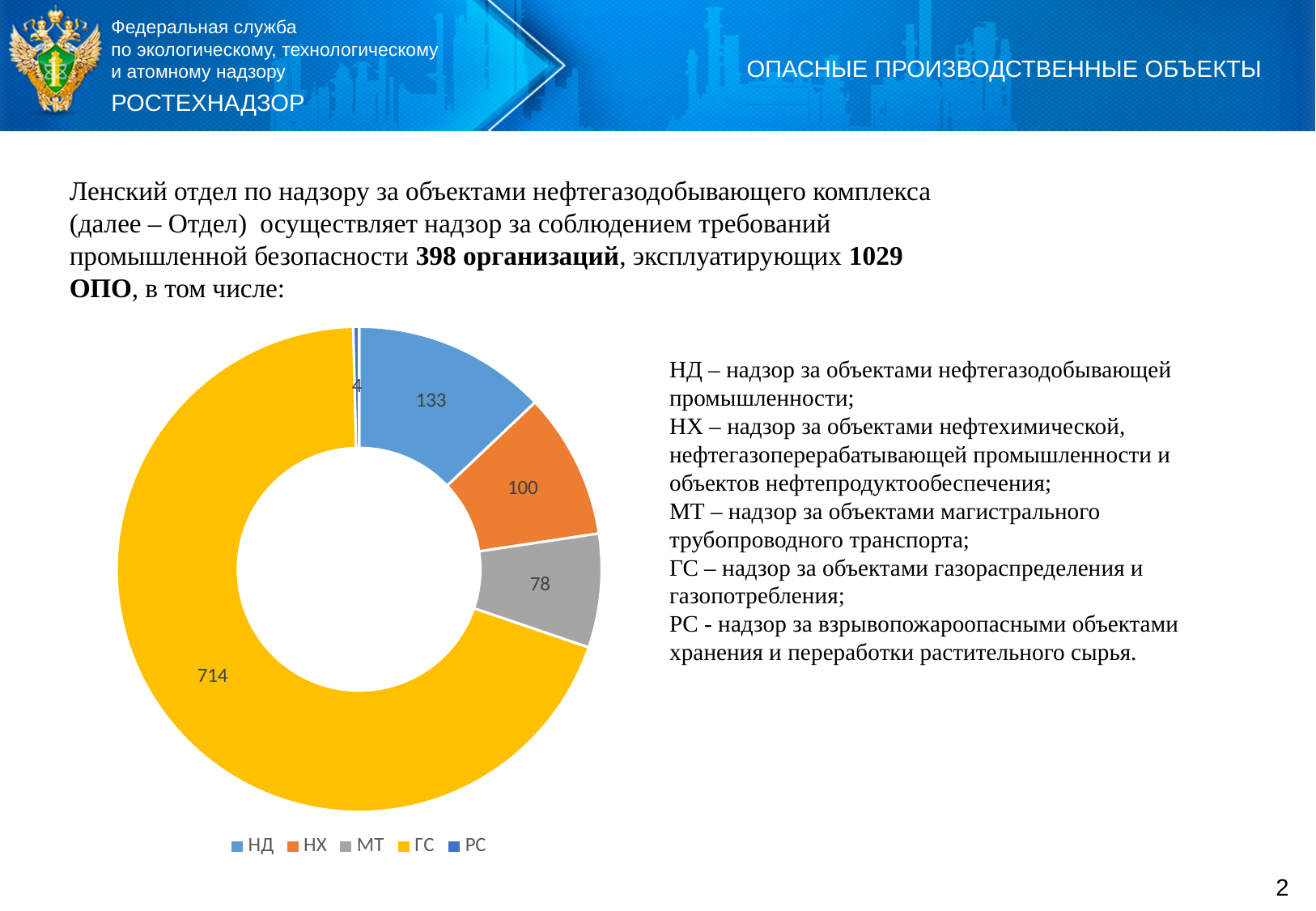
Which category has the smallest segment in the chart? РС Which category has the largest segment in the chart? ГС What is the difference between the НХ value and the МТ value? 22 What kind of chart is shown on the slide? doughnut chart What value is shown for the РС segment of the chart? 4 What is the difference between the ГС value and the НД value? 581 How many categories does the legend of the chart list? 5 What is the total of all segment values in the chart? 1029 What value is shown for the МТ segment of the chart? 78 What value is shown for the ГС segment of the chart? 714 What value is shown for the НД segment of the doughnut chart? 133 Which is larger, the value for НД or the value for НХ? НД